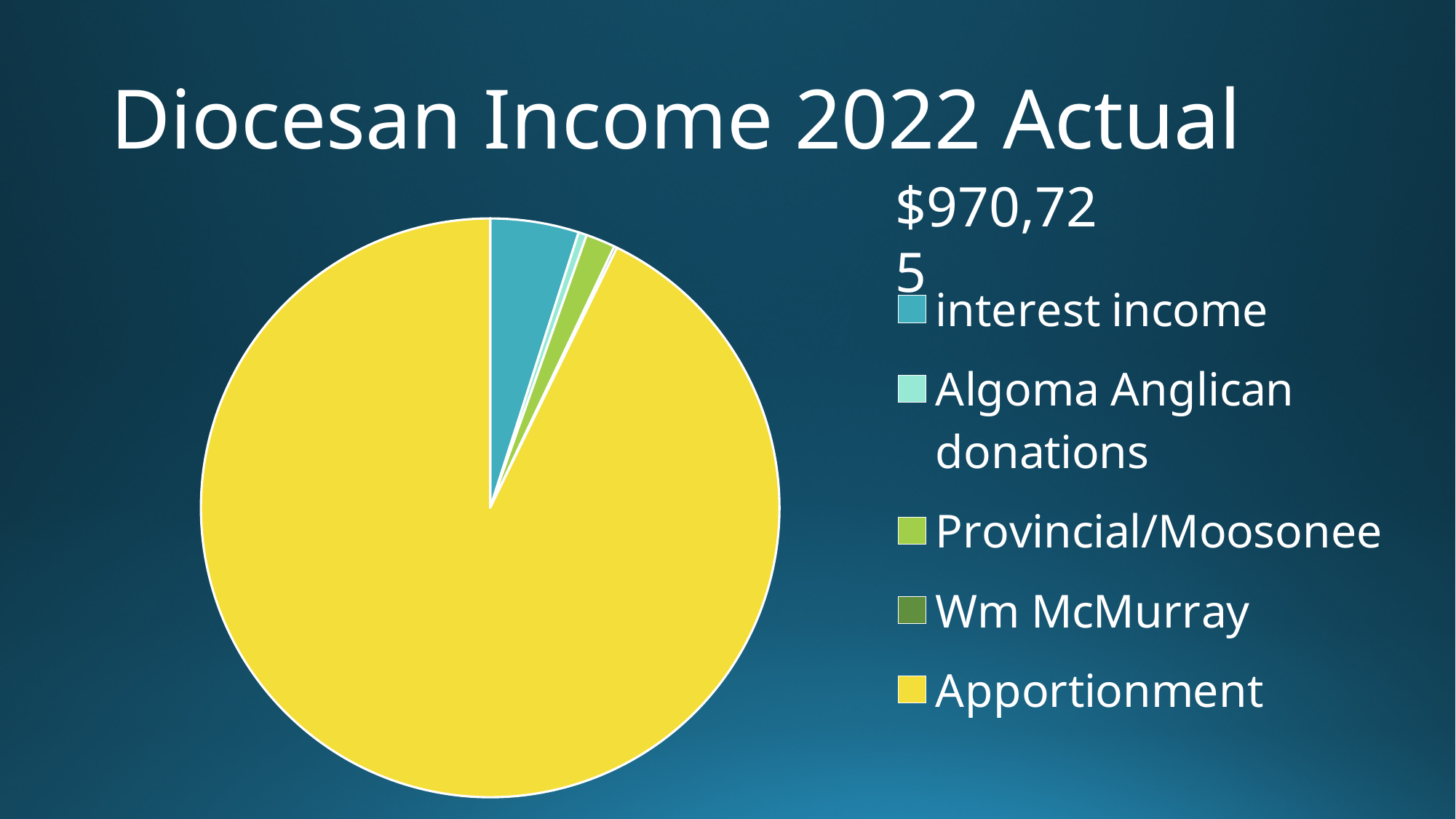
Which category has the largest slice of the pie? Apportionment Which is larger, the slice for Apportionment or the slice for interest income? Apportionment Which is larger, the slice for Apportionment or the slice for Provincial/Moosonee? Apportionment How many categories does the pie chart have? 5 What kind of chart is shown on the slide? pie chart What is the title of the chart? Diocesan Income 2022 Actual Which is larger, the slice for interest income or the slice for Provincial/Moosonee? interest income Which category is listed last in the legend? Apportionment What colour is the Apportionment slice in the pie chart? yellow